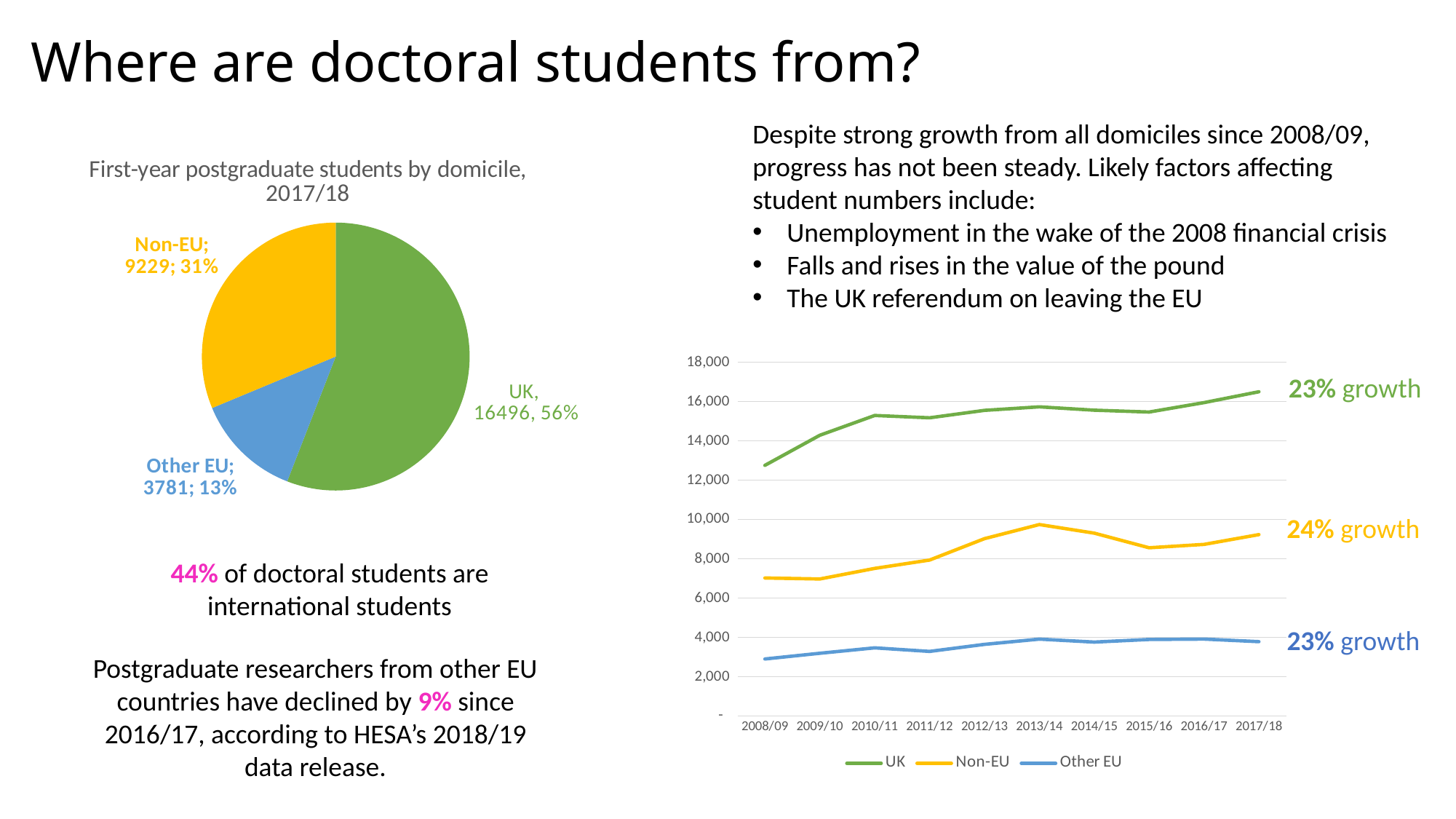
On the pie chart 'First-year postgraduate students by domicile, 2017/18', how many students are from the UK? 16496 On the line chart on the right of the slide, is the UK value for 2008/09 greater or less than 14,000? less On the pie chart 'First-year postgraduate students by domicile, 2017/18', how many domicile categories are shown? 3 On the pie chart 'First-year postgraduate students by domicile, 2017/18', which domicile has the largest slice? UK On the pie chart 'First-year postgraduate students by domicile, 2017/18', how many students are from Other EU countries? 3781 On the line chart on the right of the slide, what growth percentage is annotated for the Non-EU line? 24% On the line chart on the right of the slide, how many academic years are shown on the x axis? 10 On the line chart on the right of the slide, how many series does the legend list? 3 What kind of chart is the chart on the right of the slide? line chart On the pie chart 'First-year postgraduate students by domicile, 2017/18', which domicile has the smallest slice? Other EU On the pie chart 'First-year postgraduate students by domicile, 2017/18', what is the difference between the number of Non-EU and Other EU students? 5448 On the pie chart 'First-year postgraduate students by domicile, 2017/18', what share of students are Non-EU? 31%